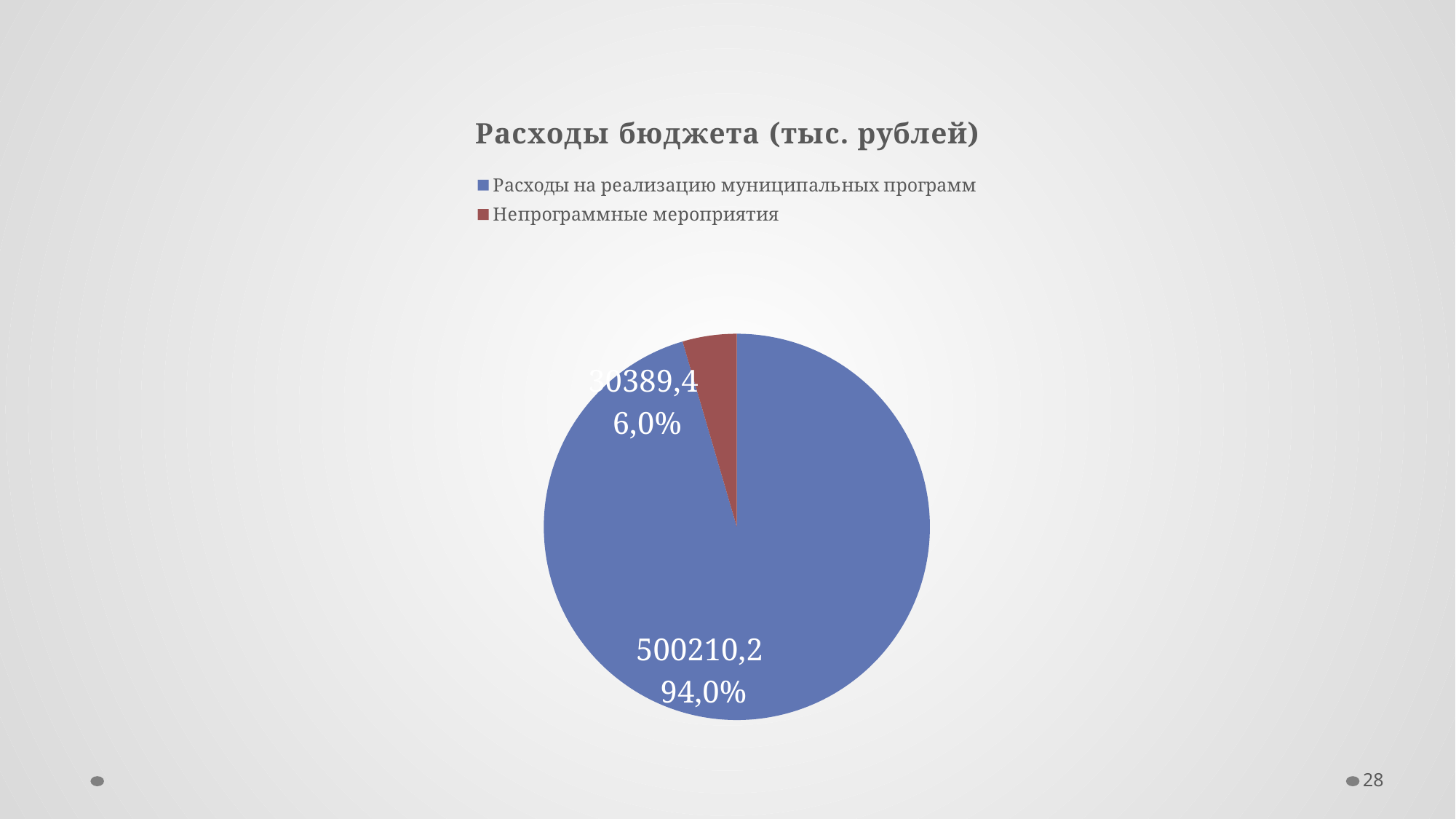
What is the difference between the values for Расходы на реализацию муниципальных программ and Непрограммные мероприятия? 469820,8 Which colour represents Непрограммные мероприятия in the chart? red How many slices does the pie chart have? 2 What is the title of the chart? Расходы бюджета (тыс. рублей) What share of the pie does Расходы на реализацию муниципальных программ represent? 94,0% How many series does the legend list? 2 Which category has the largest slice? Расходы на реализацию муниципальных программ What is the value for Расходы на реализацию муниципальных программ? 500210,2 What share of the pie does Непрограммные мероприятия represent? 6,0% What is the value for Непрограммные мероприятия? 30389,4 What kind of chart is shown on the slide? pie chart Which category has the smallest slice? Непрограммные мероприятия